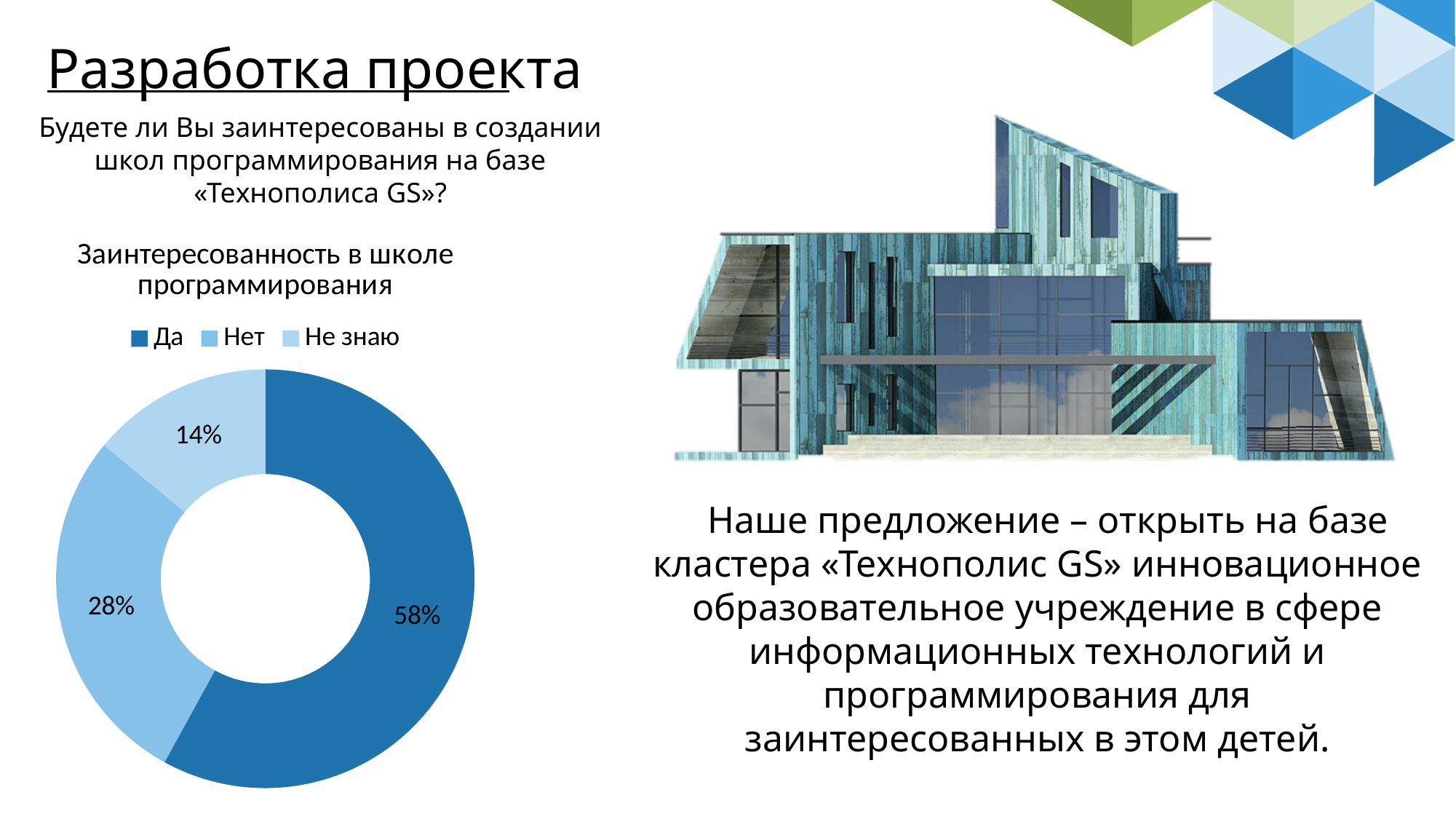
How many categories does the pie chart show? 3 What share of the pie chart is labelled "Да"? 58% How many entries does the chart legend list? 3 Which category has the smallest share in the pie chart? Не знаю What is the title of the chart? Заинтересованность в школе программирования What kind of chart is shown on the slide? Pie chart (doughnut) What share of the pie chart is labelled "Нет"? 28% Which share is larger, "Нет" or "Не знаю"? Нет What is the difference in percentage points between the "Нет" and "Не знаю" shares? 14 What is the difference in percentage points between the "Да" and "Нет" shares? 30 Which category has the largest share in the pie chart? Да What share of the pie chart is labelled "Не знаю"? 14%